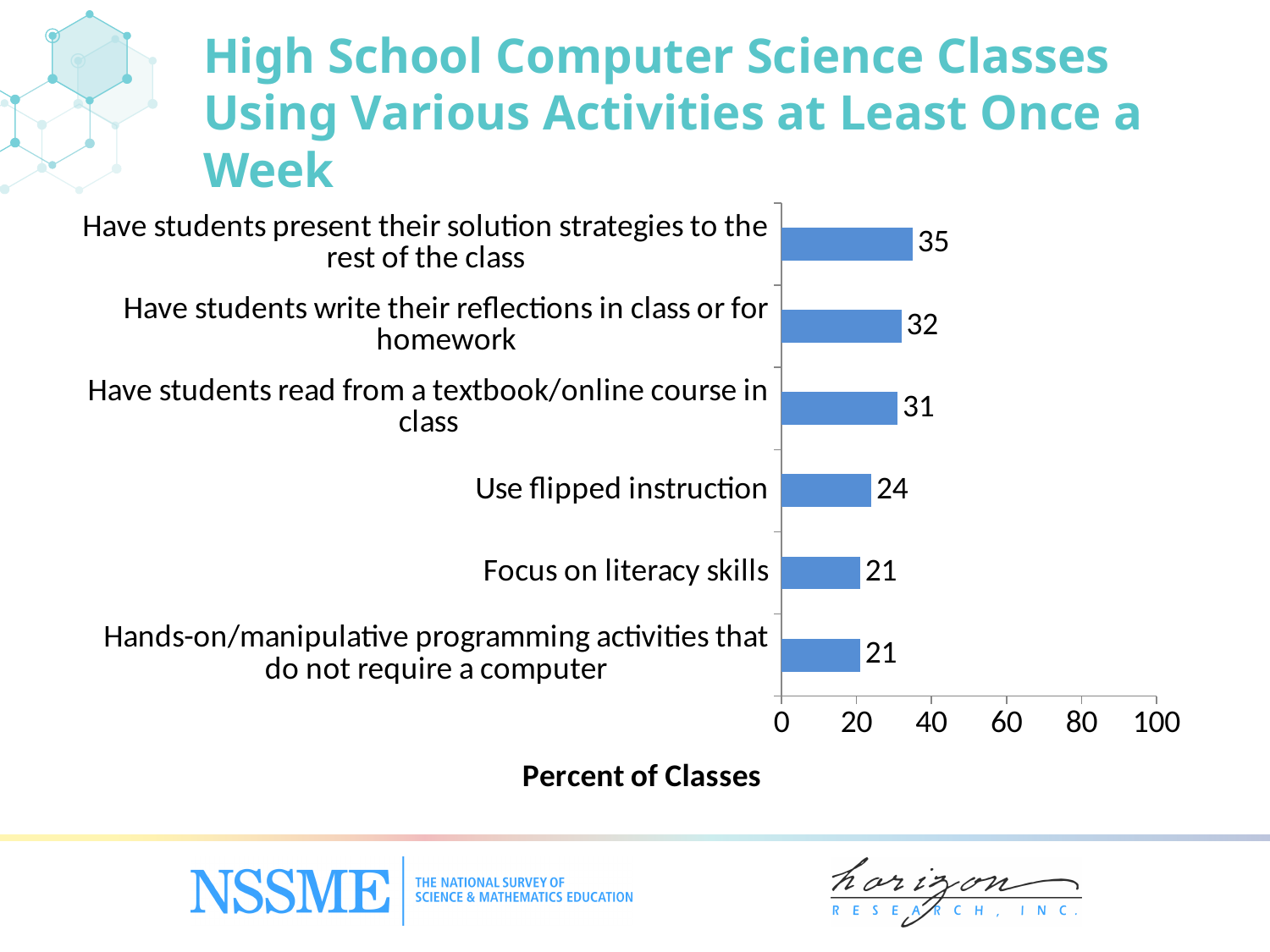
What is the difference between the values for 'Have students write their reflections in class or for homework' and 'Focus on literacy skills'? 11 Which is larger: the value for 'Use flipped instruction' or the value for 'Have students read from a textbook/online course in class'? Have students read from a textbook/online course in class How many activities are shown in the chart? 6 Is the value for 'Focus on literacy skills' greater or less than 20? greater What is the value for 'Have students read from a textbook/online course in class'? 31 What kind of chart is shown on the slide? Bar chart Which activity has the highest percent of classes? Have students present their solution strategies to the rest of the class What is the highest tick value shown on the horizontal axis? 100 Is the value for 'Have students present their solution strategies to the rest of the class' greater or less than 40? less What percent of classes have students present their solution strategies to the rest of the class at least once a week? 35 What is the value for 'Use flipped instruction'? 24 What is the label of the horizontal axis? Percent of Classes